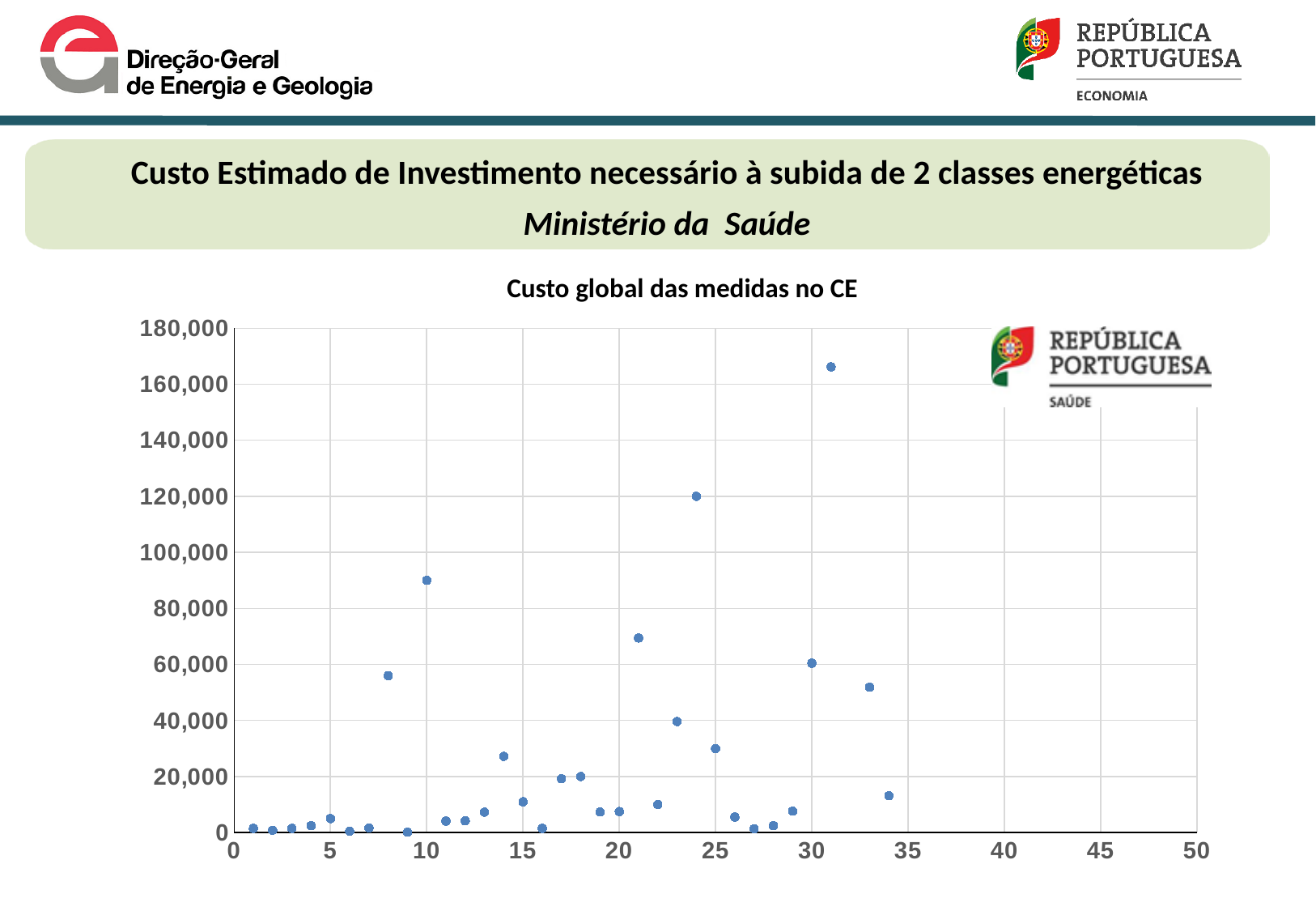
Which has the larger value, the point at x = 10 or the point at x = 8? x = 10 Is the value at x = 24 greater or less than 100,000? greater Is the value at x = 10 greater or less than 80,000? greater Is the value at x = 31 greater or less than 160,000? greater Which has the larger value, the point at x = 31 or the point at x = 24? x = 31 What kind of chart is shown on the slide? scatter chart At which x value does the chart reach its highest point? 31 What is the title of the chart? Custo global das medidas no CE What is the highest value shown on the vertical axis? 180,000